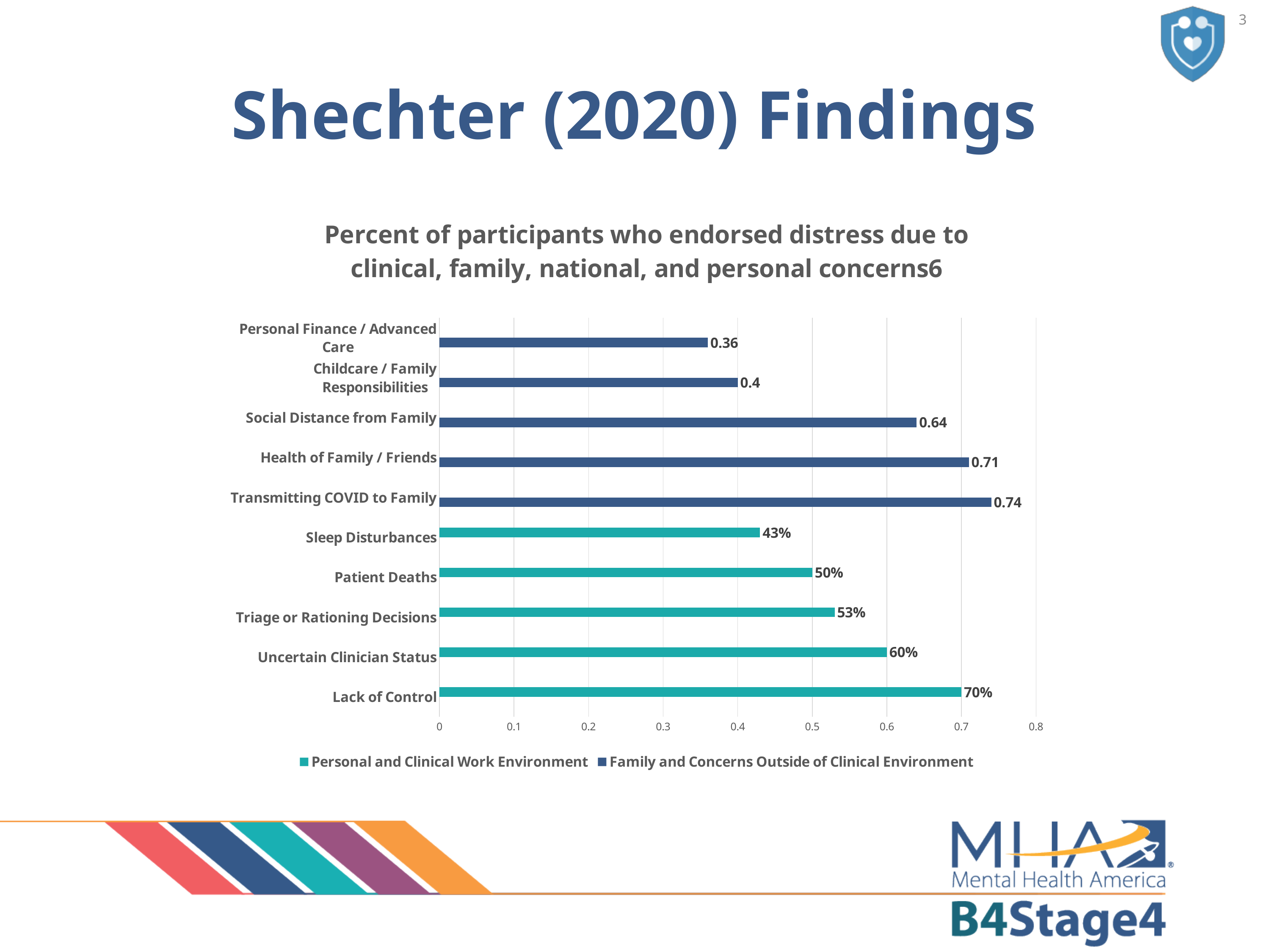
What is the value for Sleep Disturbances? 43% What is the value for Transmitting COVID to Family? 0.74 How many series does the legend list? 2 What kind of chart is shown on the slide? Bar chart How many categories are shown in the chart? 10 What is the value for Childcare / Family Responsibilities? 0.4 Which series does the Lack of Control bar belong to, according to the legend? Personal and Clinical Work Environment Which category has the longest bar? Transmitting COVID to Family What is the difference between the values for Lack of Control and Uncertain Clinician Status? 10% What is the difference between the values for Transmitting COVID to Family and Health of Family / Friends? 0.03 Which category has the shortest bar? Personal Finance / Advanced Care Which is larger, the value for Social Distance from Family or the value for Patient Deaths? Social Distance from Family